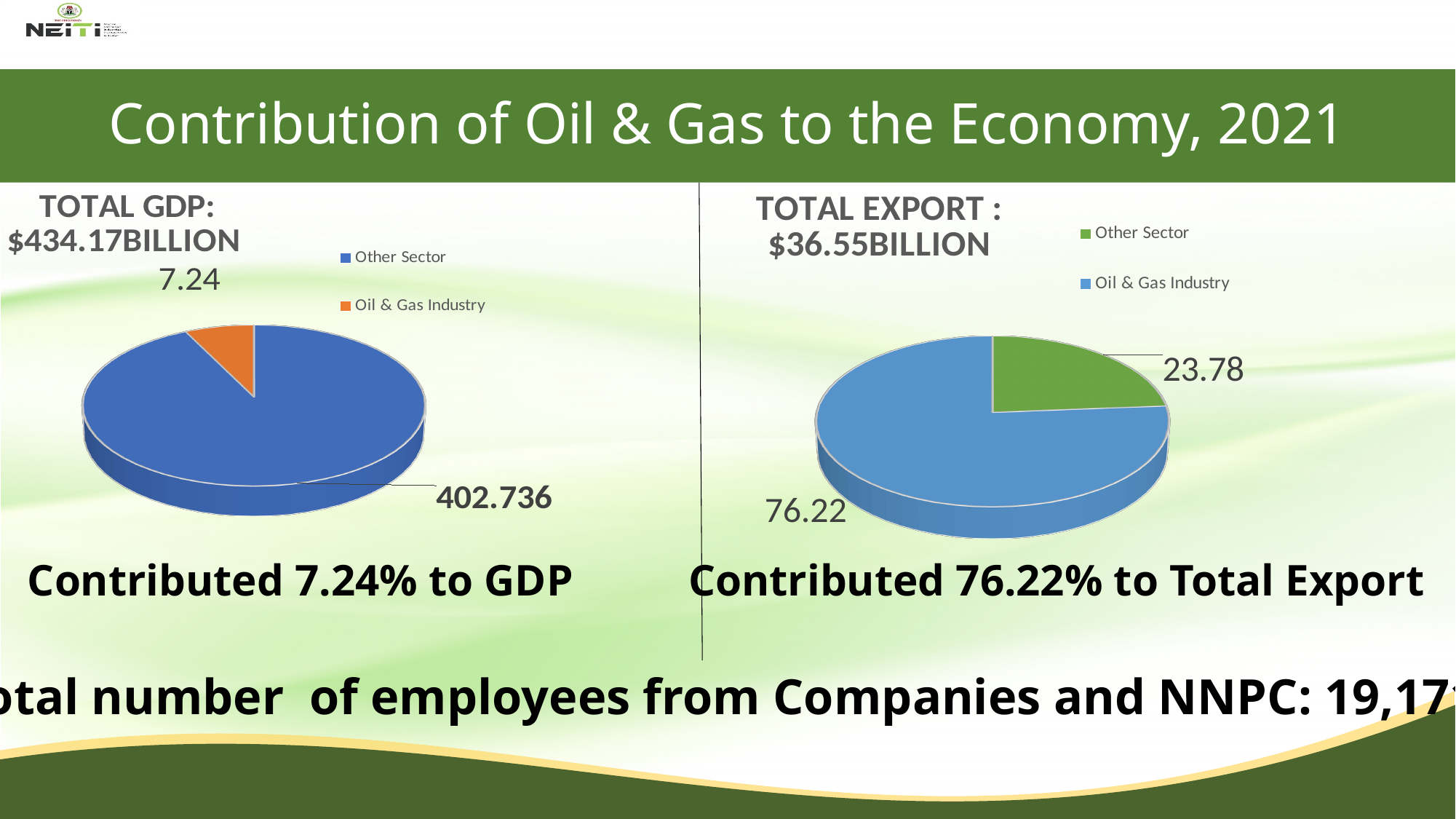
In the TOTAL EXPORT pie chart, what value is shown for the Oil & Gas Industry slice? 76.22 In the TOTAL GDP pie chart, what value is shown for the Other Sector slice? 402.736 In the TOTAL EXPORT pie chart, which category has the smallest slice? Other Sector In the TOTAL EXPORT pie chart, which is larger: Oil & Gas Industry or Other Sector? Oil & Gas Industry In the TOTAL EXPORT pie chart, what is the difference between the Oil & Gas Industry and Other Sector values? 52.44 In the TOTAL GDP pie chart, which category has the largest slice? Other Sector How many slices does the TOTAL GDP pie chart have? 2 How many entries does the legend of the TOTAL EXPORT chart list? 2 In the TOTAL EXPORT pie chart, what colour represents the Other Sector slice? Green What type of chart is used on the left side of the slide for TOTAL GDP? Pie chart In the TOTAL EXPORT pie chart, what value is shown for the Other Sector slice? 23.78 In the TOTAL GDP pie chart, what value is shown for the Oil & Gas Industry slice? 7.24